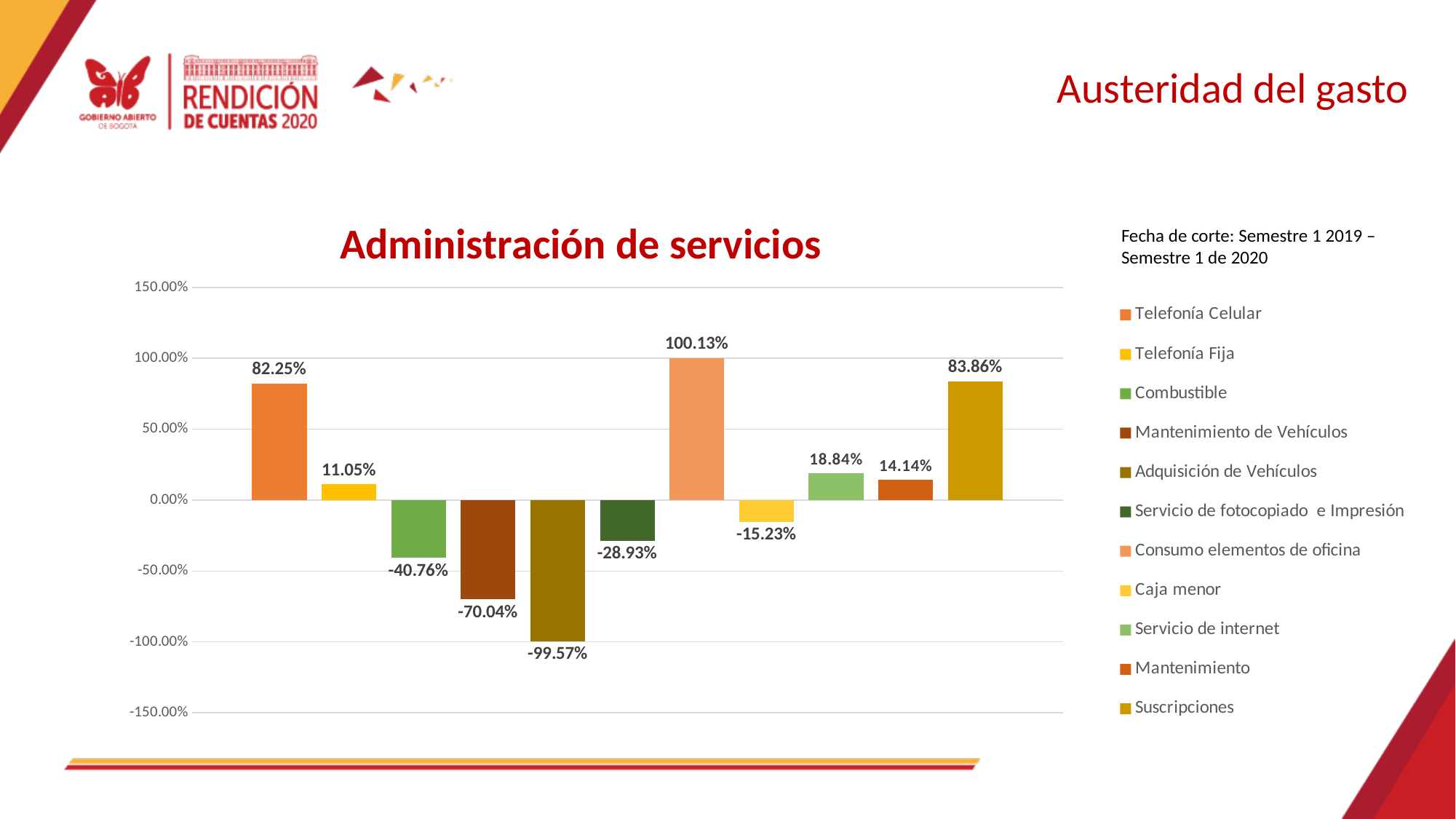
What kind of chart is shown on the slide? bar chart How many bars are plotted in the chart? 11 What is the difference between the values for Suscripciones and Telefonía Celular? 1.61% Which category has the highest value? Consumo elementos de oficina How many series does the legend list? 11 Which category has the lowest value? Adquisición de Vehículos What is the value for Adquisición de Vehículos? -99.57% What is the value for Caja menor? -15.23% Is the value for Mantenimiento de Vehículos greater or less than -50.00%? less What is the value for Telefonía Celular? 82.25% Which is larger, the value for Servicio de internet or the value for Mantenimiento? Servicio de internet What is the value for Servicio de internet? 18.84%